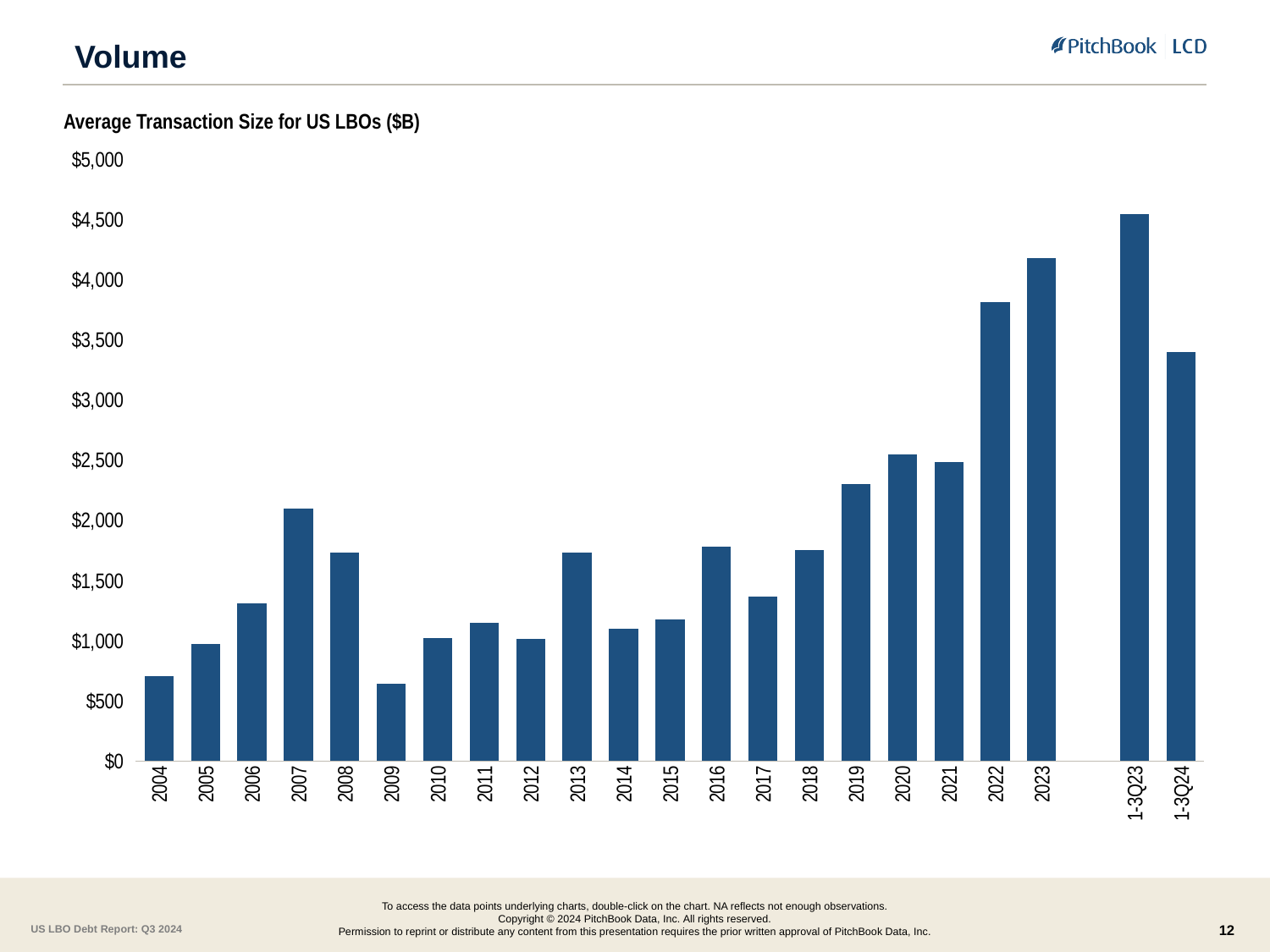
Which category has the highest average transaction size? 1-3Q23 Is the value for 2007 greater or less than $2,000? greater Is the value for 2009 greater or less than $1,000? less Which year has the lowest average transaction size? 2009 Do the values rise or fall from 2019 to 2023? rise Is the value for 2023 greater or less than $4,000? greater What is the title of the chart? Average Transaction Size for US LBOs ($B) What kind of chart is shown on the slide? bar chart Which is larger, the value for 2007 or the value for 2008? 2007 How many bars are plotted in the chart? 22